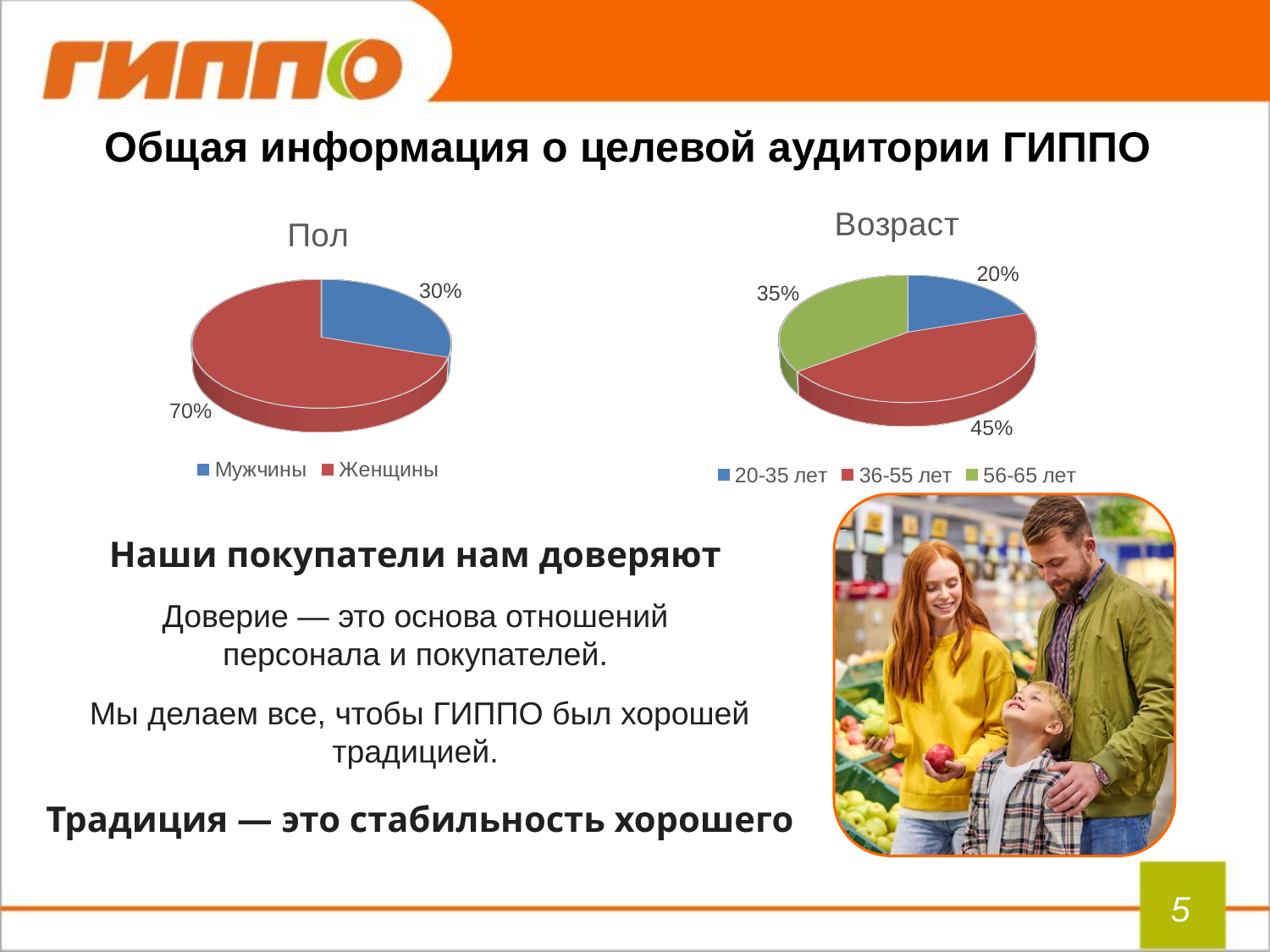
In the "Возраст" chart, which age group has the smallest share? 20-35 лет In the "Пол" chart, what colour is the Мужчины slice? Blue In the "Возраст" chart, what share is 56-65 лет? 35% In the "Пол" chart, what is the difference between the Женщины and Мужчины shares? 40% How many categories does the "Возраст" chart show? 3 In the "Пол" chart, what share is Мужчины? 30% In the "Возраст" chart, which age group has the largest share? 36-55 лет In the "Пол" chart, what share is Женщины? 70% In the "Возраст" chart, what share is 20-35 лет? 20% What kind of chart is the "Пол" chart? Pie chart In the "Возраст" chart, which is larger: 56-65 лет or 20-35 лет? 56-65 лет In the "Возраст" chart, what share is 36-55 лет? 45%